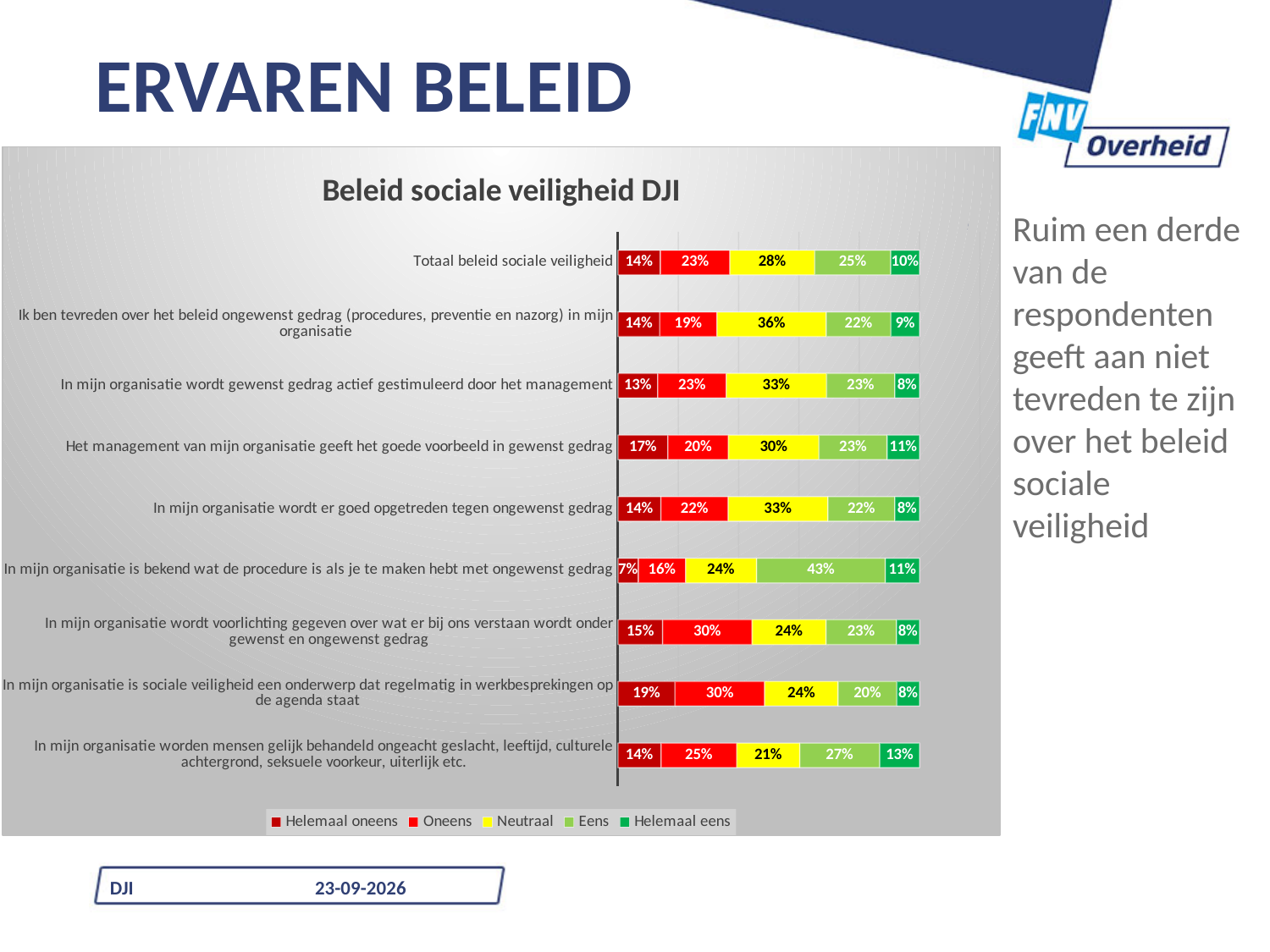
What is the 'Eens' value for 'In mijn organisatie is bekend wat de procedure is als je te maken hebt met ongewenst gedrag'? 43% How many series does the legend list? 5 What is the total of the stacked bar for 'Totaal beleid sociale veiligheid'? 100% Which category has the lowest 'Helemaal oneens' value? In mijn organisatie is bekend wat de procedure is als je te maken hebt met ongewenst gedrag How many categories (statements) are shown in the chart? 9 Which is larger: the 'Oneens' value for 'In mijn organisatie wordt voorlichting gegeven over wat er bij ons verstaan wordt onder gewenst en ongewenst gedrag' or the 'Oneens' value for 'Het management van mijn organisatie geeft het goede voorbeeld in gewenst gedrag'? In mijn organisatie wordt voorlichting gegeven over wat er bij ons verstaan wordt onder gewenst en ongewenst gedrag Which category has the highest 'Eens' value? In mijn organisatie is bekend wat de procedure is als je te maken hebt met ongewenst gedrag What is the value of 'Neutraal' for 'Totaal beleid sociale veiligheid'? 28% What kind of chart is shown on the slide? Stacked bar chart What is the title of the chart? Beleid sociale veiligheid DJI What is the difference between the 'Neutraal' value for 'Ik ben tevreden over het beleid ongewenst gedrag (procedures, preventie en nazorg) in mijn organisatie' and the 'Neutraal' value for 'Totaal beleid sociale veiligheid'? 8% What is the 'Helemaal eens' value for 'In mijn organisatie worden mensen gelijk behandeld ongeacht geslacht, leeftijd, culturele achtergrond, seksuele voorkeur, uiterlijk etc.'? 13%